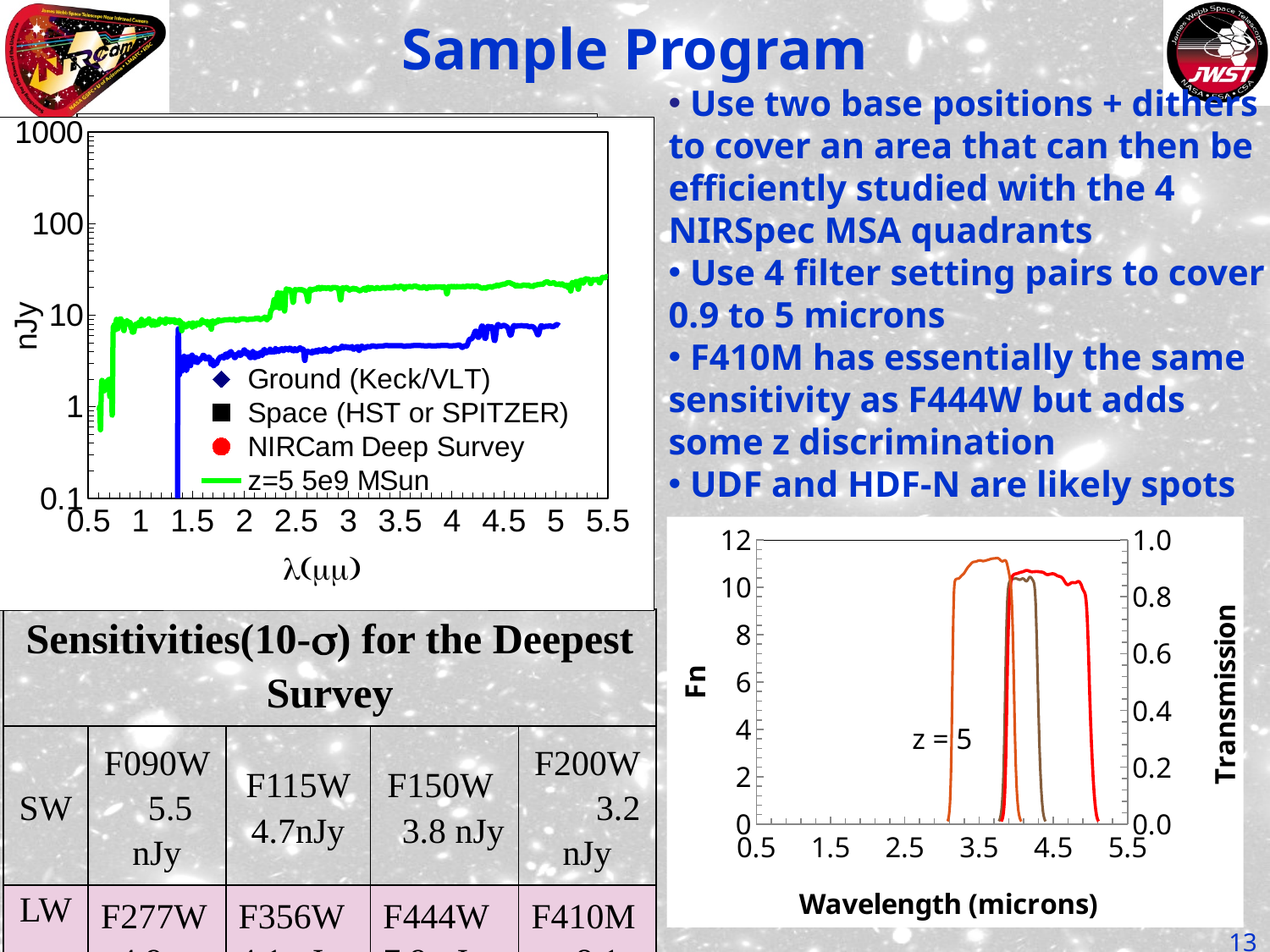
What is the label of the right-hand y-axis of the bottom-right chart? Transmission How many series does the legend of the top-left chart list? 4 In the top-left chart, at 4 μm, which line is higher: the green line or the blue line? the green line In the bottom-right chart, is the value of the red curve at 4.5 microns greater or less than 8 on the left Fn axis? greater What kind of chart is the bottom-right chart with the Wavelength (microns) axis? line chart What is the x-axis label of the top-left chart? λ(μμ) In the bottom-right chart, is the peak of the orange curve greater or less than 10 on the left Fn axis? greater In the top-left chart, is the value of the blue line at 3 μm greater or less than 1 nJy? greater What kind of chart is the top-left chart with the nJy axis? line chart In the top-left chart, does the green z=5 5e9 MSun line generally rise or fall as wavelength increases from 0.5 to 5.5 μm? rise